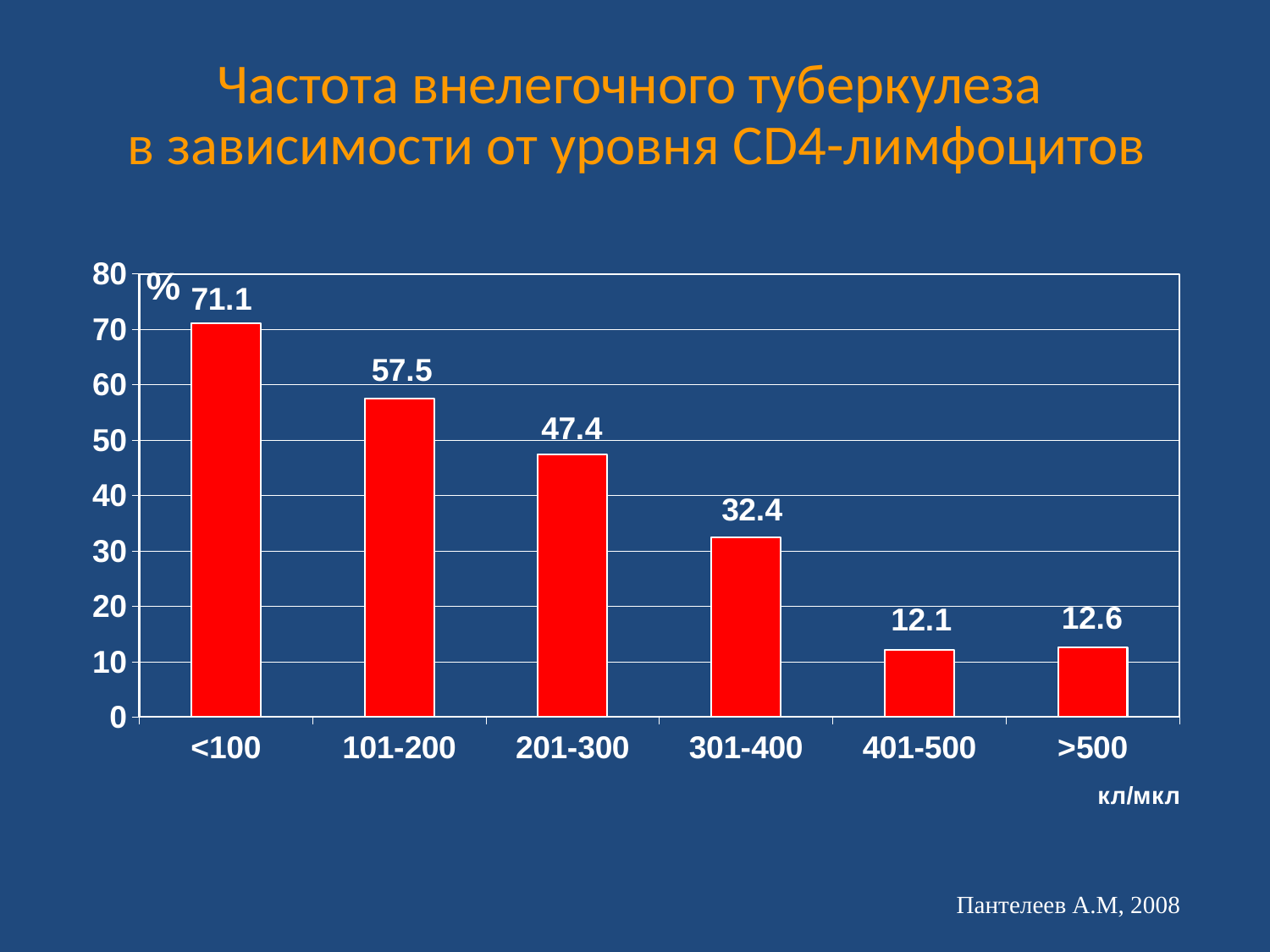
What is the value for the >500 category? 12.6 What is the difference between the values for 201-300 and 301-400? 15 Which category has the lowest value? 401-500 What is the value for the <100 category? 71.1 Which category has the highest value? <100 What is the difference between the values for <100 and 101-200? 13.6 Is the value for 201-300 greater or less than 50? less What kind of chart is shown on the slide? bar chart How many categories are shown on the x axis? 6 What unit is shown on the x axis label? кл/мкл Which is larger, the value for 101-200 or the value for 201-300? 101-200 What is the value for the 301-400 category? 32.4